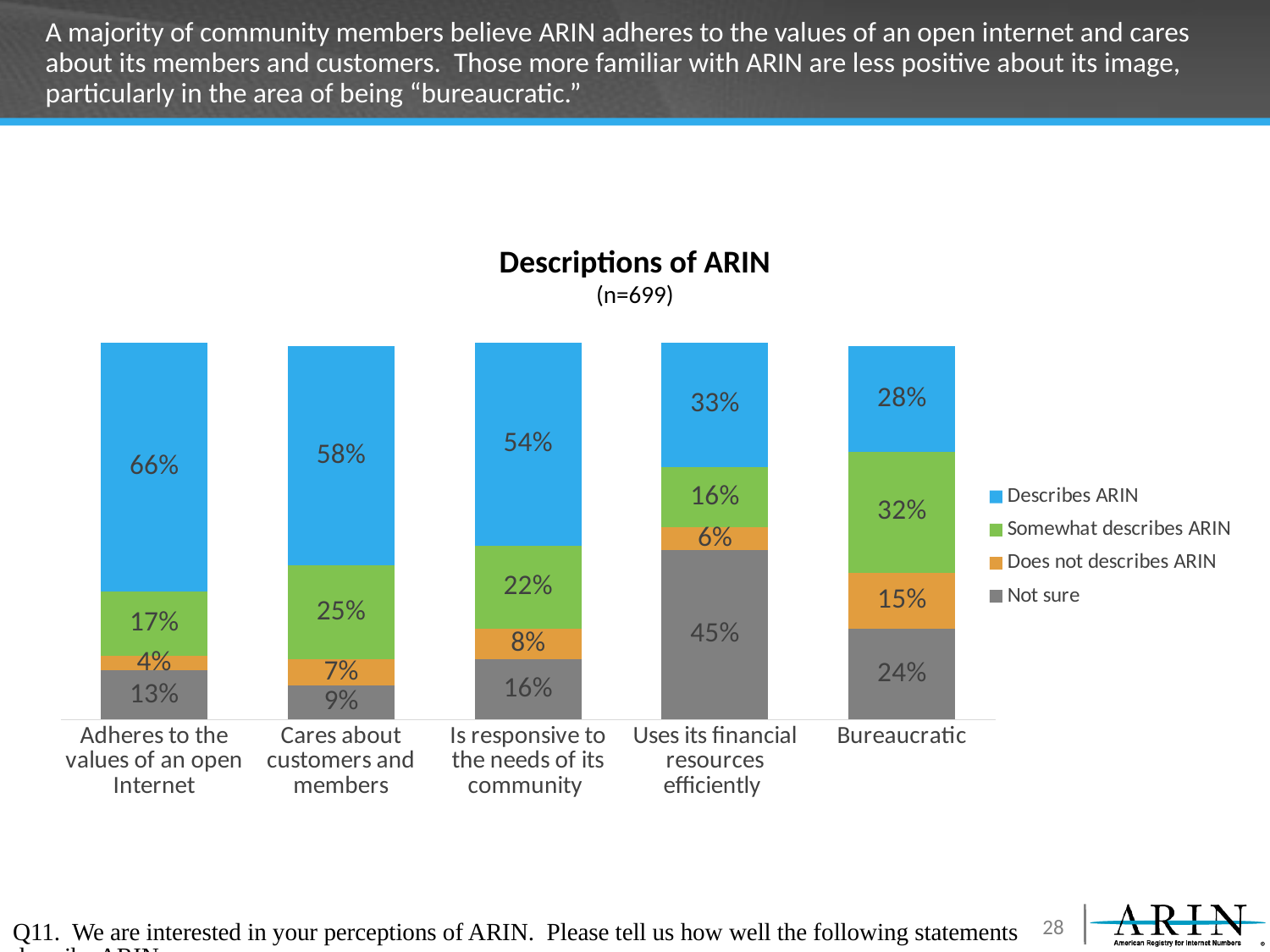
What kind of chart is shown on the slide? Stacked bar chart What is the "Not sure" value for "Uses its financial resources efficiently"? 45% How many series does the legend list? 4 What is the difference between the "Describes ARIN" values for "Cares about customers and members" and "Bureaucratic"? 30% Which is larger: the "Not sure" value for "Bureaucratic" or for "Is responsive to the needs of its community"? Bureaucratic Which category has the highest "Describes ARIN" value? Adheres to the values of an open Internet How many categories are shown on the x axis of the chart? 5 What percentage of respondents said "Describes ARIN" for "Adheres to the values of an open Internet"? 66% Which category has the lowest "Not sure" value? Cares about customers and members What is the "Does not describes ARIN" value for "Is responsive to the needs of its community"? 8% What is the sample size shown under the chart title? n=699 What is the "Somewhat describes ARIN" value for "Bureaucratic"? 32%